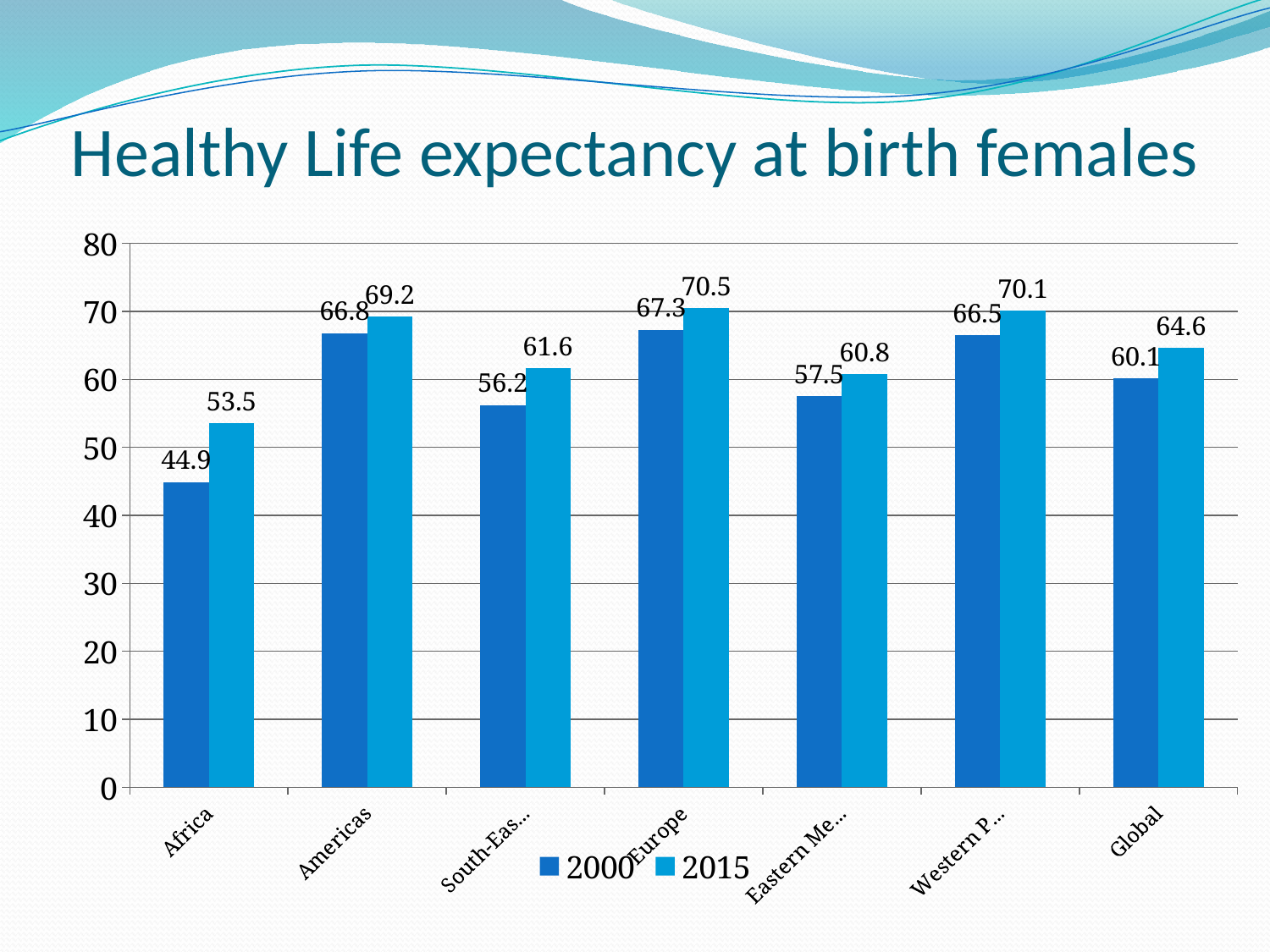
Which is larger in the 2015 series: Americas or Global? Americas Is the 2000 value for Africa greater or less than 50? less What is the value for Americas in the 2015 series? 69.2 What is the value for Global in the 2000 series? 60.1 How many categories are shown on the x axis? 7 Which category has the lowest value in the 2000 series? Africa How many series does the legend list? 2 What is the difference between the 2015 and 2000 values for Africa? 8.6 Which category has the highest value in the 2015 series? Europe What kind of chart is shown on the slide? bar chart What is the value for Africa in the 2000 series? 44.9 What is the value for Europe in the 2015 series? 70.5